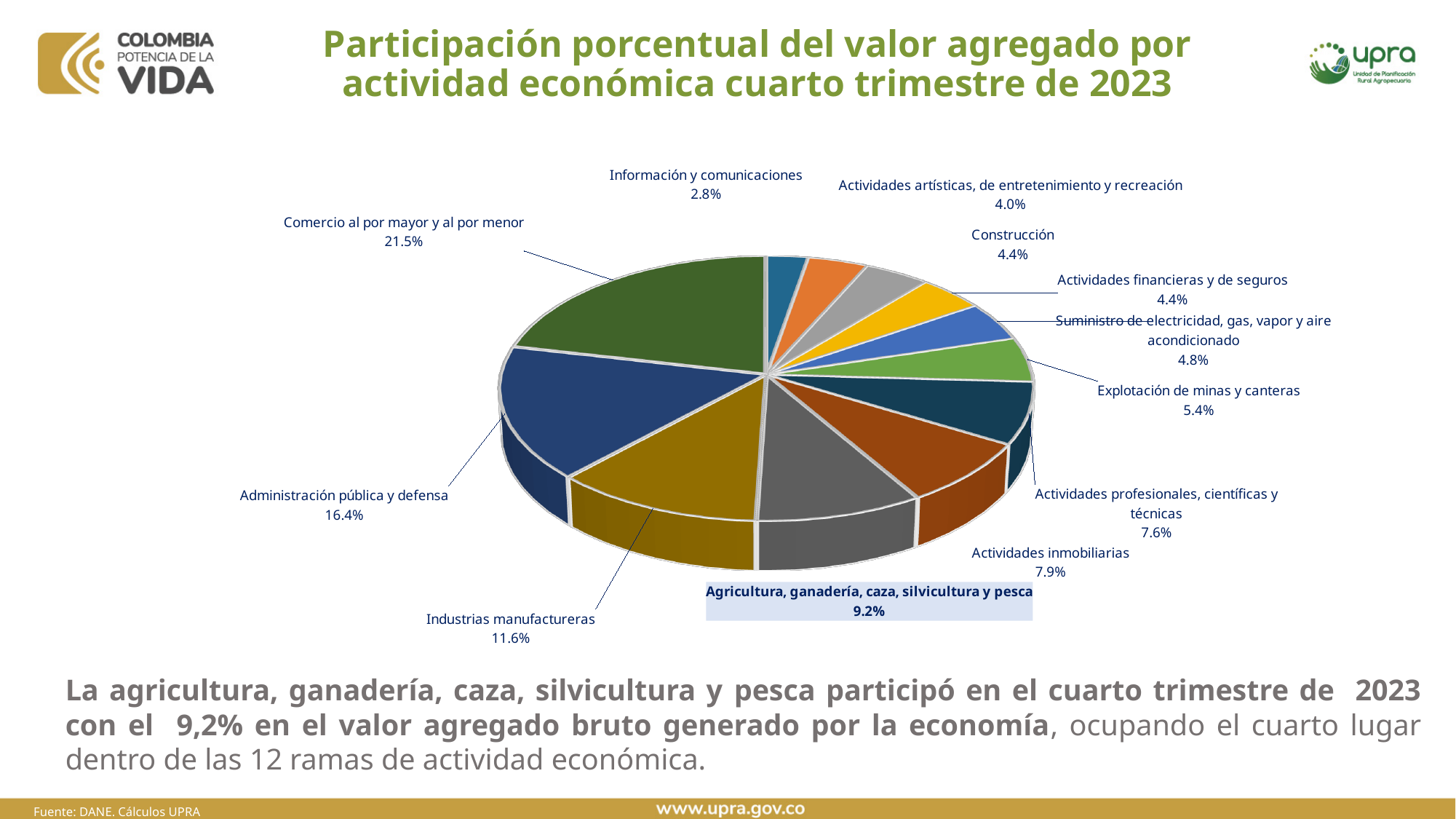
Which has a larger share, Actividades inmobiliarias or Actividades profesionales, científicas y técnicas? Actividades inmobiliarias What is the combined share of Construcción and Actividades financieras y de seguros? 8.8% Which activity has the largest share of the pie? Comercio al por mayor y al por menor What is the difference between the shares of Comercio al por mayor y al por menor and Administración pública y defensa? 5.1% Which activity has the smallest share of the pie? Información y comunicaciones What is the title of the chart? Participación porcentual del valor agregado por actividad económica cuarto trimestre de 2023 What is the share for Industrias manufactureras? 11.6% What is the share for Explotación de minas y canteras? 5.4% How many slices does the pie chart have? 12 What kind of chart is shown on the slide? Pie chart What is the share for Agricultura, ganadería, caza, silvicultura y pesca? 9.2% What share of the pie does Suministro de electricidad, gas, vapor y aire acondicionado represent? 4.8%